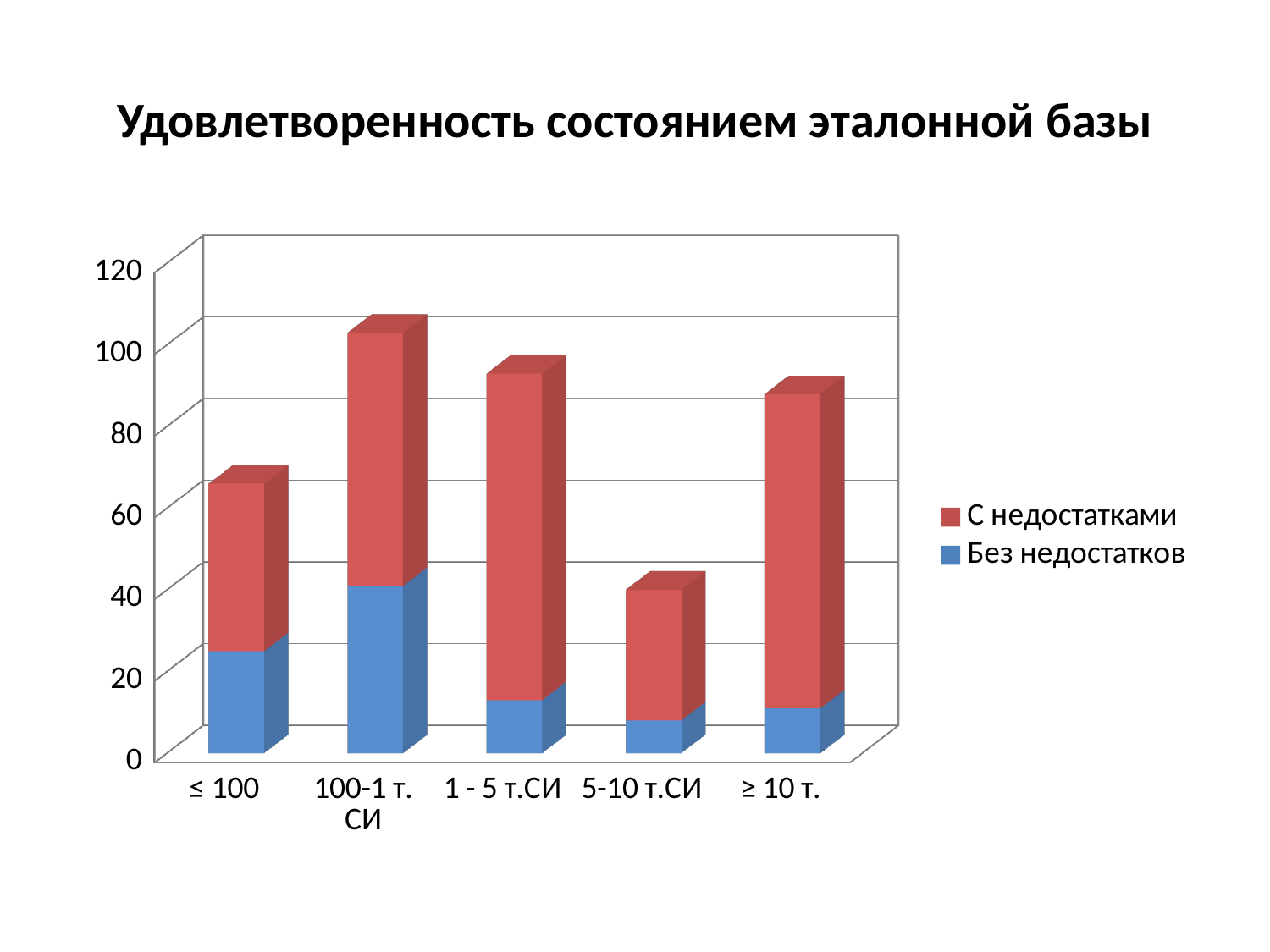
Is the value of Без недостатков for 100-1 т. СИ greater or less than 20? greater Which has the larger total stacked value: ≤ 100 or ≥ 10 т.? ≥ 10 т. Which category has the shortest stacked bar overall? 5-10 т.СИ Which category has the tallest stacked bar overall? 100-1 т. СИ What kind of chart is shown on the slide? Stacked bar chart How many series does the legend list? 2 Which category has the larger Без недостатков value: ≤ 100 or 5-10 т.СИ? ≤ 100 How many categories are shown on the x axis? 5 What is the title of the chart? Удовлетворенность состоянием эталонной базы Which series is shown in blue? Без недостатков Is the total stacked value for ≤ 100 greater or less than 40? greater Is the total stacked value for 5-10 т.СИ greater or less than 60? less